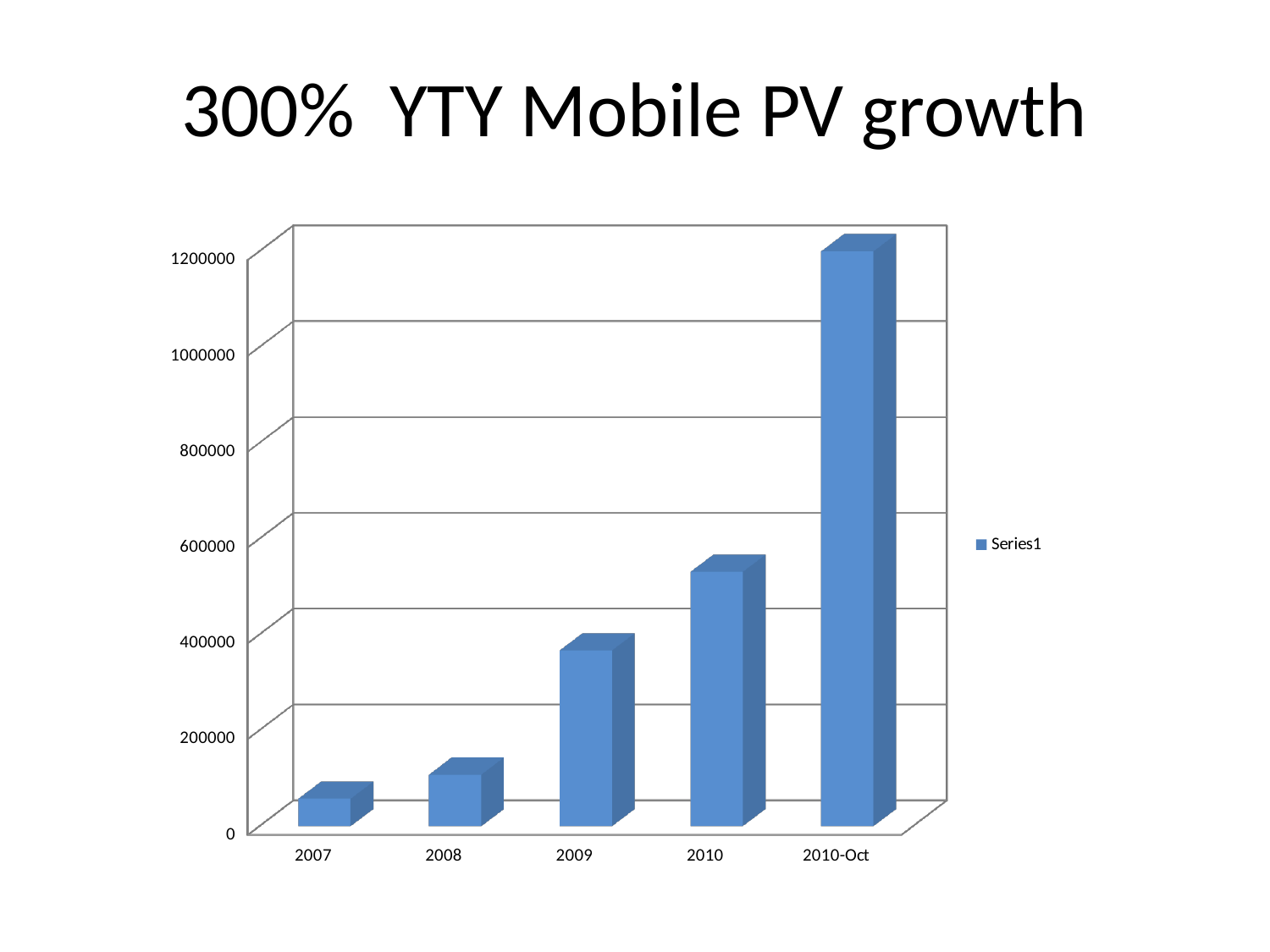
Is the value for 2010-Oct greater or less than 1000000? greater Which category has the lowest value? 2007 Which is larger, the value for 2009 or the value for 2010? 2010 How many series does the legend list? 1 Is the value for 2008 greater or less than 200000? less What is the title of the slide? 300% YTY Mobile PV growth Is the value for 2010 greater or less than 400000? greater Which category has the highest value? 2010-Oct Do the values rise or fall from 2007 to 2010-Oct? rise What kind of chart is shown on the slide? bar chart How many categories are plotted along the x axis? 5